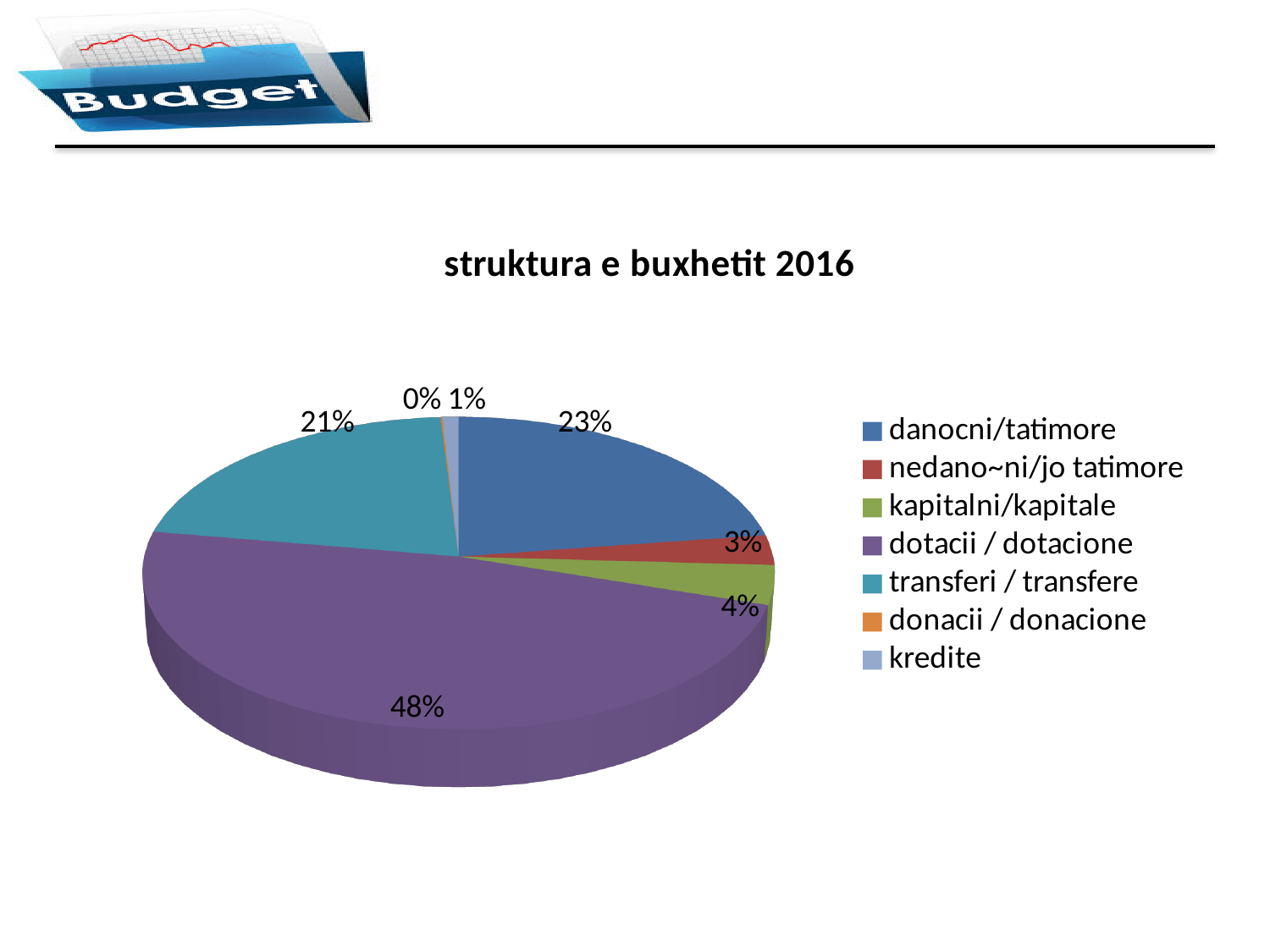
What share of the pie is danocni/tatimore? 23% How many categories does the legend list? 7 What share of the pie is dotacii / dotacione? 48% What is the title of the chart? struktura e buxhetit 2016 Which is larger, the share of danocni/tatimore or the share of transferi / transfere? danocni/tatimore What share of the pie is transferi / transfere? 21% What kind of chart is shown on the slide? pie chart What is the difference between the shares of dotacii / dotacione and danocni/tatimore? 25% Which category has the smallest share of the pie? donacii / donacione Which category has the largest share of the pie? dotacii / dotacione